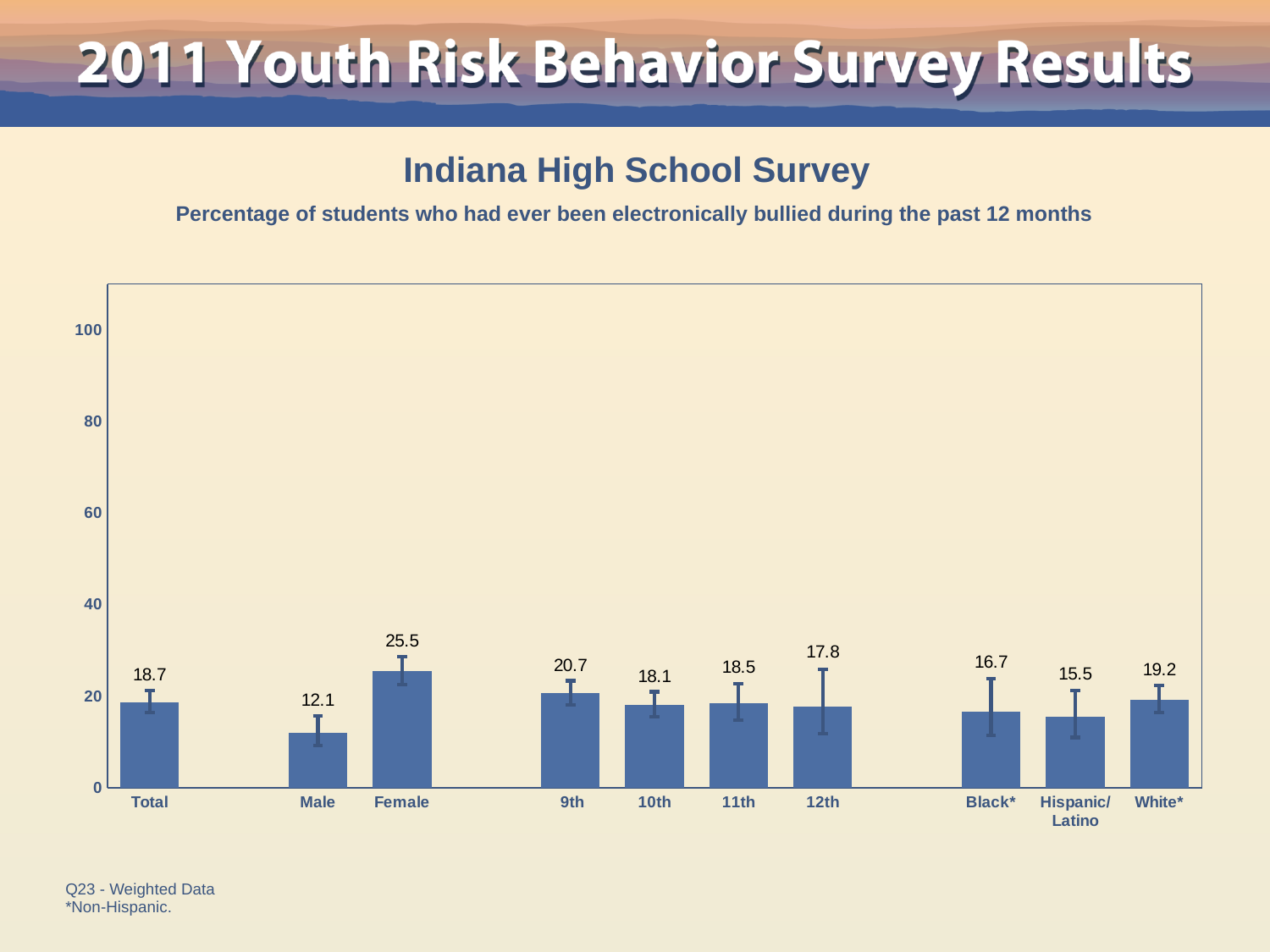
What is the value for Hispanic/Latino? 15.5 Which category has the highest value? Female What is the difference between the Female and Male values? 13.4 Which is larger, the value for 9th or the value for 12th? 9th Is the value for Female greater or less than 20? greater What is the value for Female? 25.5 What is the value for Male? 12.1 What is the subtitle describing what the chart measures? Percentage of students who had ever been electronically bullied during the past 12 months What kind of chart is this? bar chart Which category has the lowest value? Male How many categories are shown on the x axis? 10 What is the value for Total? 18.7